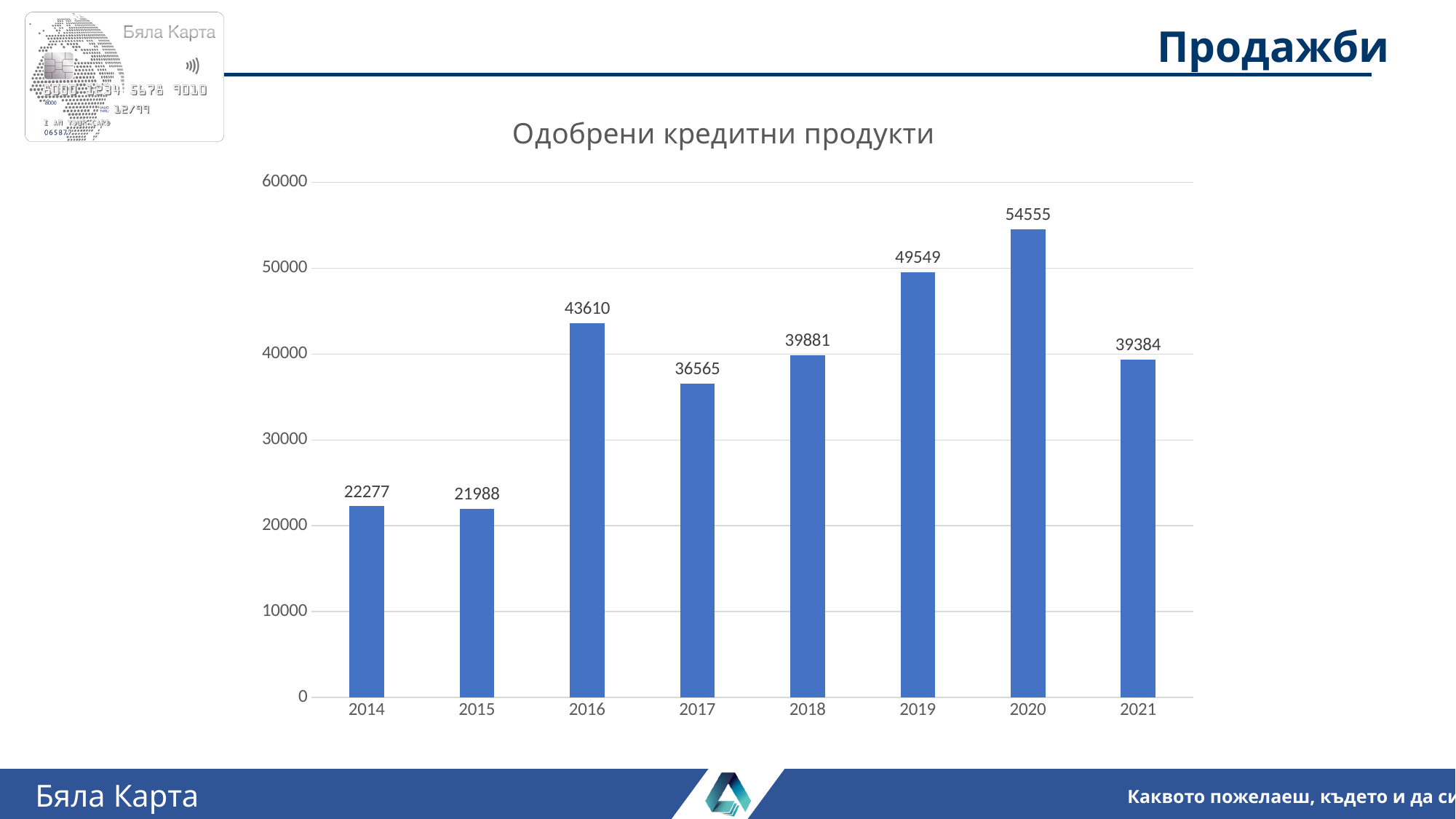
Do the values rise or fall from 2017 to 2020? rise Which is larger, the value for 2018 or the value for 2021? 2018 What is the value for 2021? 39384 Which year has the lowest value? 2015 What is the difference between the values for 2016 and 2017? 7045 How many years are shown on the x axis? 8 What is the value for 2016? 43610 Which year has the highest value? 2020 Is the value for 2019 greater or less than 40000? greater What is the difference between the values for 2020 and 2019? 5006 What is the title of the chart? Одобрени кредитни продукти What kind of chart is shown? bar chart